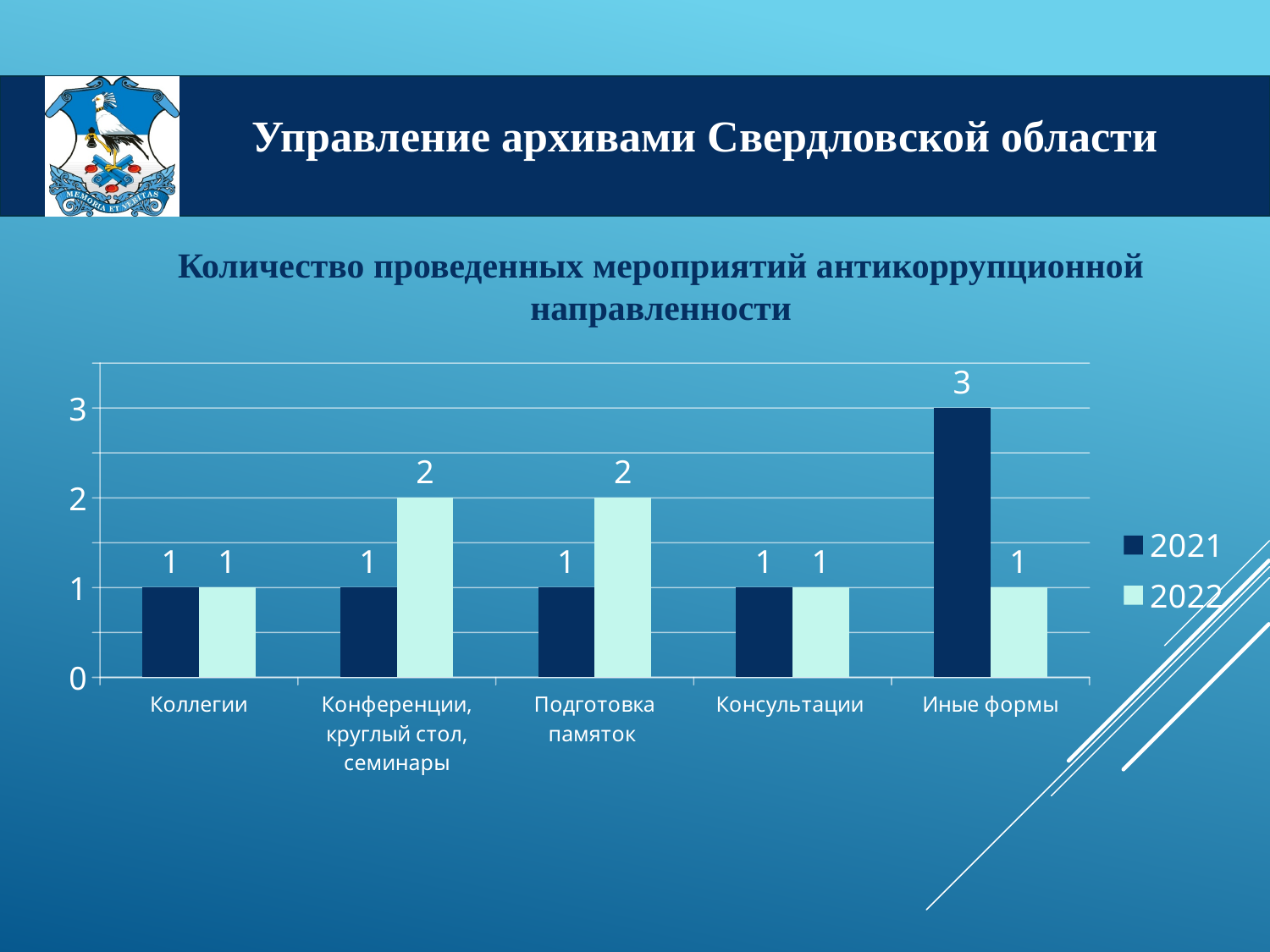
Which category has the highest value for the 2021 series? Иные формы How many categories are shown on the x axis? 5 What is the difference between the 2021 and 2022 values in the category Иные формы? 2 What is the value for 2022 in the category Подготовка памяток? 2 Which is larger in the category Иные формы: the 2021 value or the 2022 value? 2021 What is the value for 2022 in the category Конференции, круглый стол, семинары? 2 How many series does the legend list? 2 What is the value for 2021 in the category Коллегии? 1 What kind of chart is shown on the slide? Bar chart What is the title of the chart? Количество проведенных мероприятий антикоррупционной направленности What is the value for 2021 in the category Иные формы? 3 Which is larger in the category Подготовка памяток: the 2021 value or the 2022 value? 2022